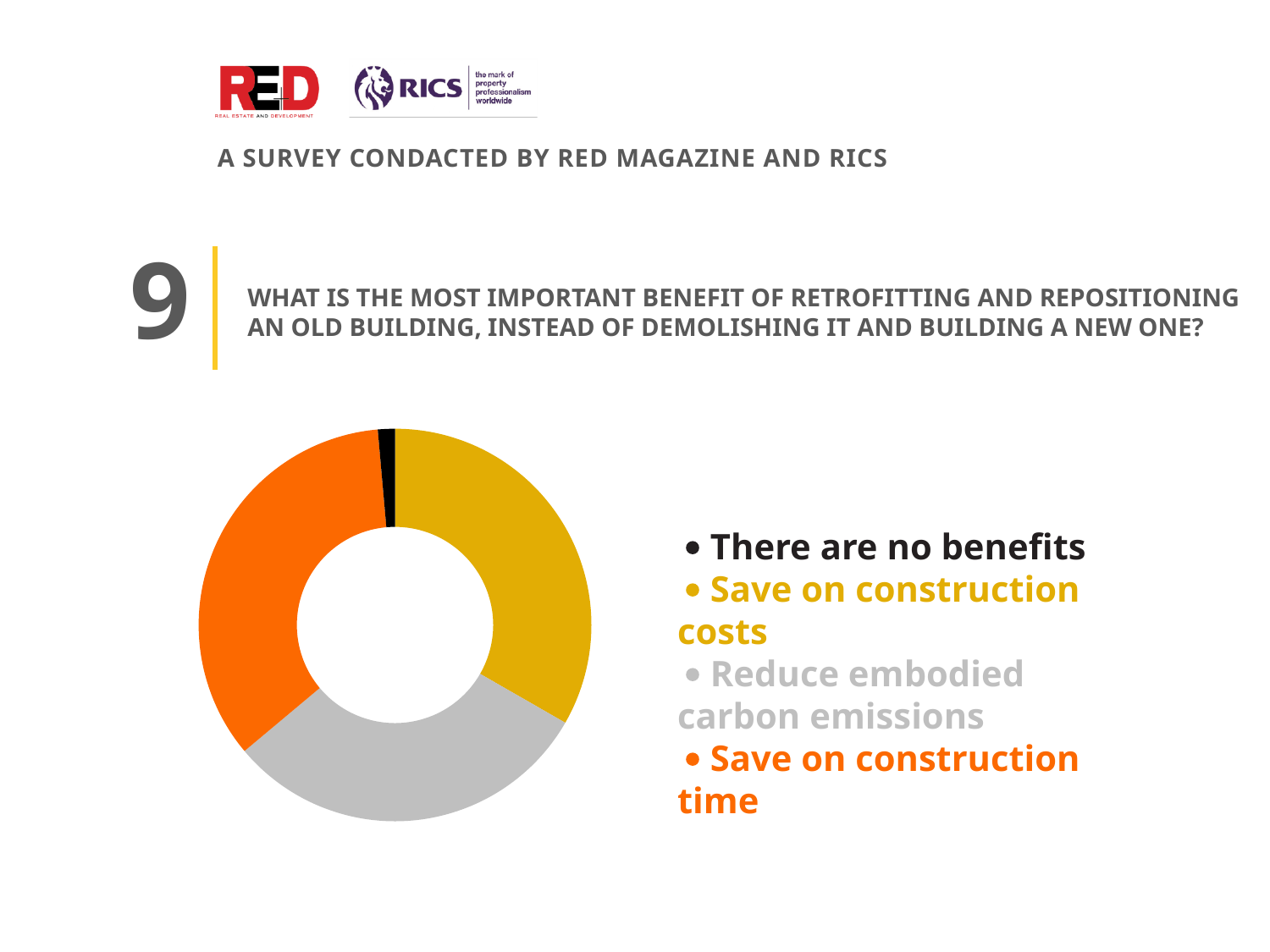
Which is larger: the share for 'Save on construction time' or the share for 'There are no benefits'? Save on construction time Which category is shown in grey in the chart? Reduce embodied carbon emissions Which is larger: the share for 'Reduce embodied carbon emissions' or the share for 'There are no benefits'? Reduce embodied carbon emissions How many categories does the chart show? 4 Which category has the smallest share of the chart? There are no benefits What colour represents 'Save on construction time' in the chart? Orange What kind of chart is shown on the slide? Pie chart (donut) How many entries does the legend list? 4 Which is larger: the share for 'There are no benefits' or the share for 'Save on construction costs'? Save on construction costs